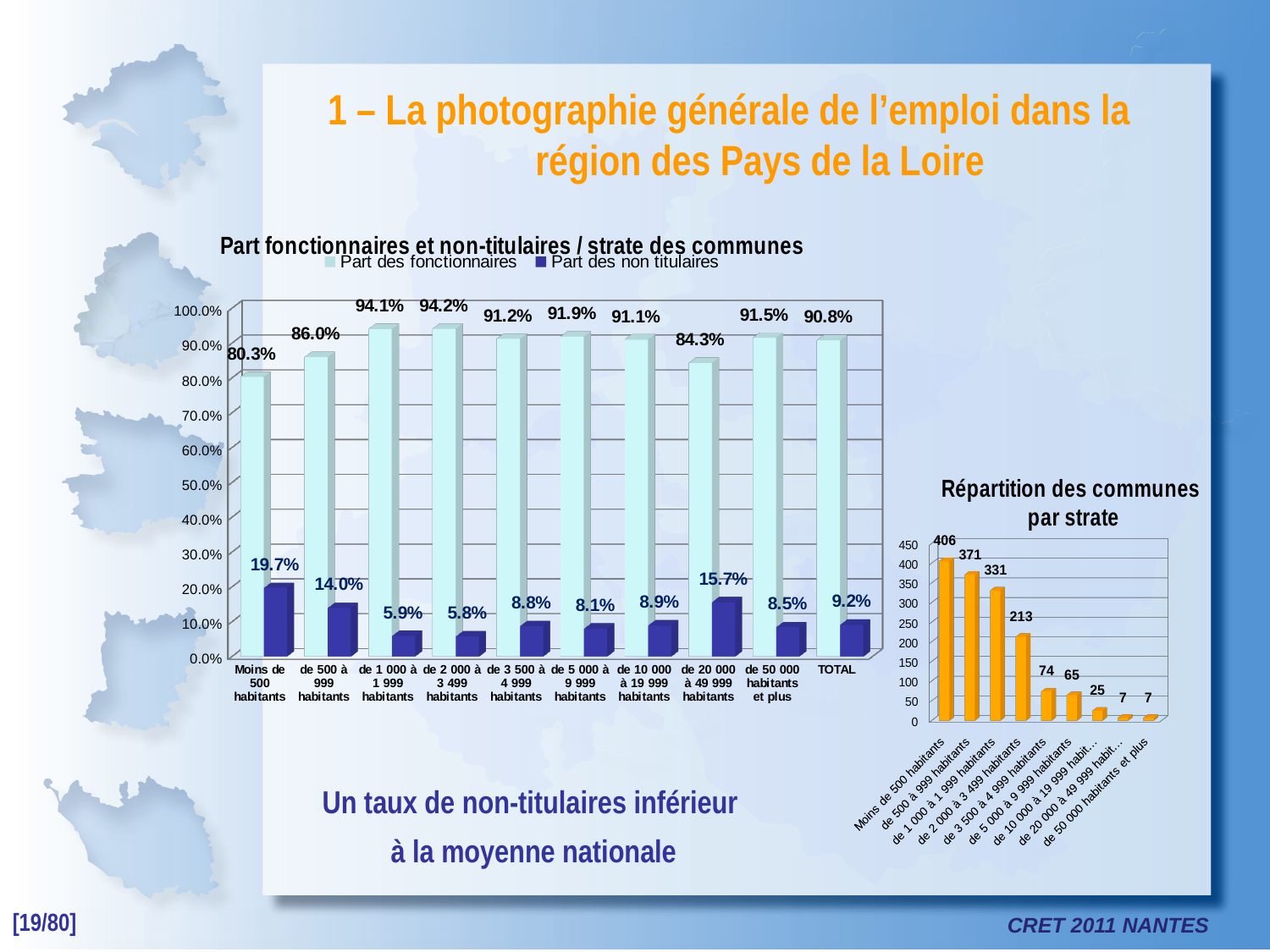
How many series does the legend of the chart 'Part fonctionnaires et non-titulaires / strate des communes' list? 2 In the chart 'Répartition des communes par strate', what is the difference between the values for 'Moins de 500 habitants' and 'de 500 à 999 habitants'? 35 What kind of chart is 'Répartition des communes par strate'? Bar chart How many categories are shown on the x axis of the chart 'Part fonctionnaires et non-titulaires / strate des communes'? 10 In the chart 'Part fonctionnaires et non-titulaires / strate des communes', which category has the highest 'Part des non titulaires'? Moins de 500 habitants In the chart 'Répartition des communes par strate', which category has the highest value? Moins de 500 habitants In the chart 'Part fonctionnaires et non-titulaires / strate des communes', which category has the lowest 'Part des fonctionnaires'? Moins de 500 habitants In the chart 'Part fonctionnaires et non-titulaires / strate des communes', what is the difference between 'Part des non titulaires' for 'de 20 000 à 49 999 habitants' and for 'de 50 000 habitants et plus'? 7.2% In the chart 'Part fonctionnaires et non-titulaires / strate des communes', what is the value of 'Part des fonctionnaires' for 'Moins de 500 habitants'? 80.3% In the chart 'Répartition des communes par strate', what is the value for 'de 2 000 à 3 499 habitants'? 213 In the chart 'Part fonctionnaires et non-titulaires / strate des communes', what is the value of 'Part des non titulaires' for 'TOTAL'? 9.2% In the chart 'Part fonctionnaires et non-titulaires / strate des communes', which is larger: 'Part des fonctionnaires' for 'de 500 à 999 habitants' or for 'de 20 000 à 49 999 habitants'? de 500 à 999 habitants